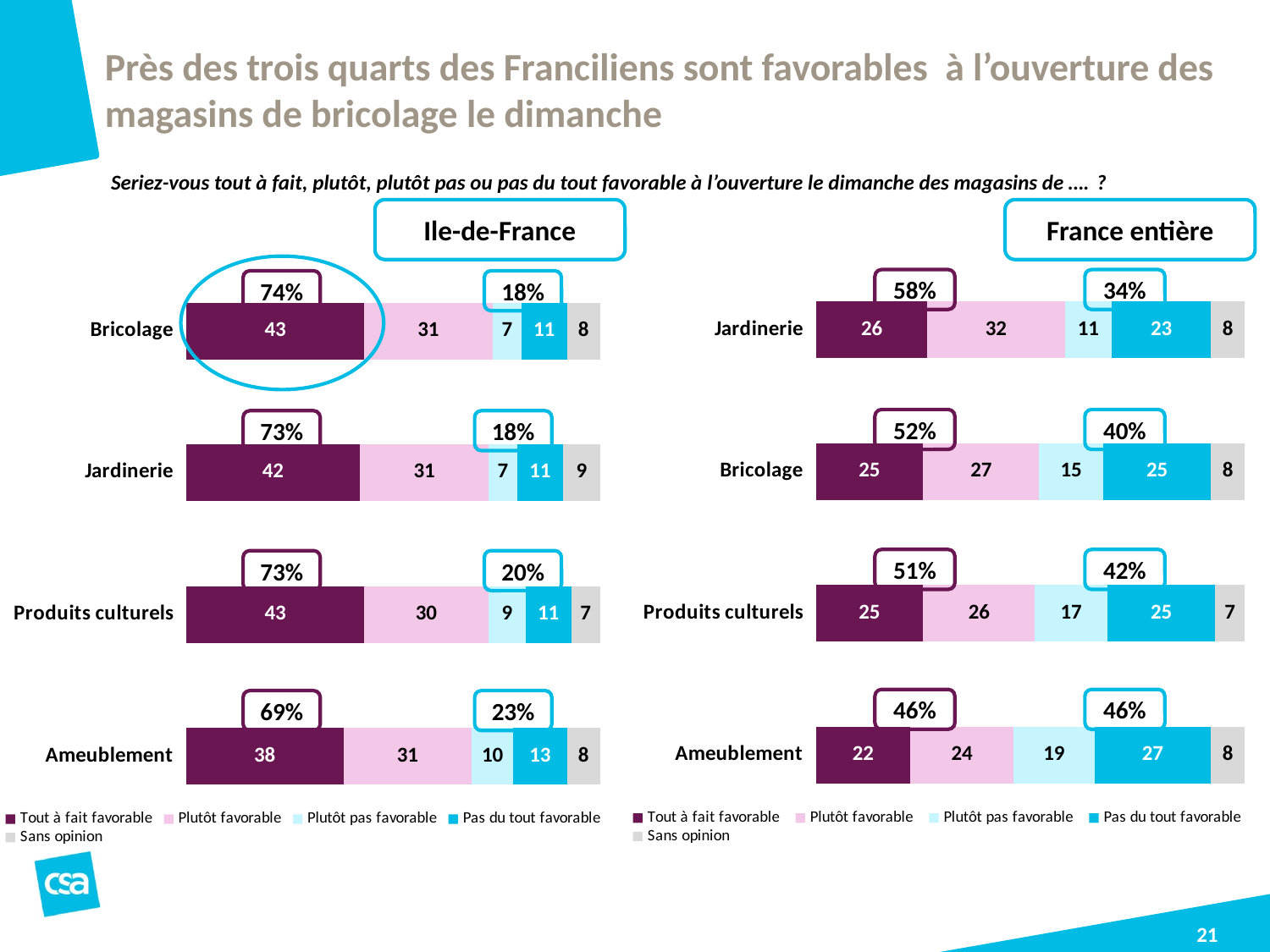
In the France entière chart, what is the 'Plutôt pas favorable' value for Produits culturels? 17 In the France entière chart, which category has the highest 'Plutôt favorable' value? Jardinerie How many categories are shown in the Ile-de-France chart? 4 In the France entière chart, what is the total of the 'Tout à fait favorable' and 'Plutôt favorable' values for Ameublement? 46 What kind of chart is the Ile-de-France chart? Stacked bar chart In the Ile-de-France chart, what is the 'Sans opinion' value for Jardinerie? 9 In the Ile-de-France chart, what is the difference between the 'Tout à fait favorable' values for Bricolage and Ameublement? 5 In the France entière chart, which is larger: the 'Pas du tout favorable' value for Jardinerie or for Bricolage? Bricolage In the France entière chart, what is the 'Pas du tout favorable' value for Ameublement? 27 In the Ile-de-France chart, which category has the lowest 'Tout à fait favorable' value? Ameublement How many series does the legend of the France entière chart list? 5 In the Ile-de-France chart, what is the 'Tout à fait favorable' value for Bricolage? 43